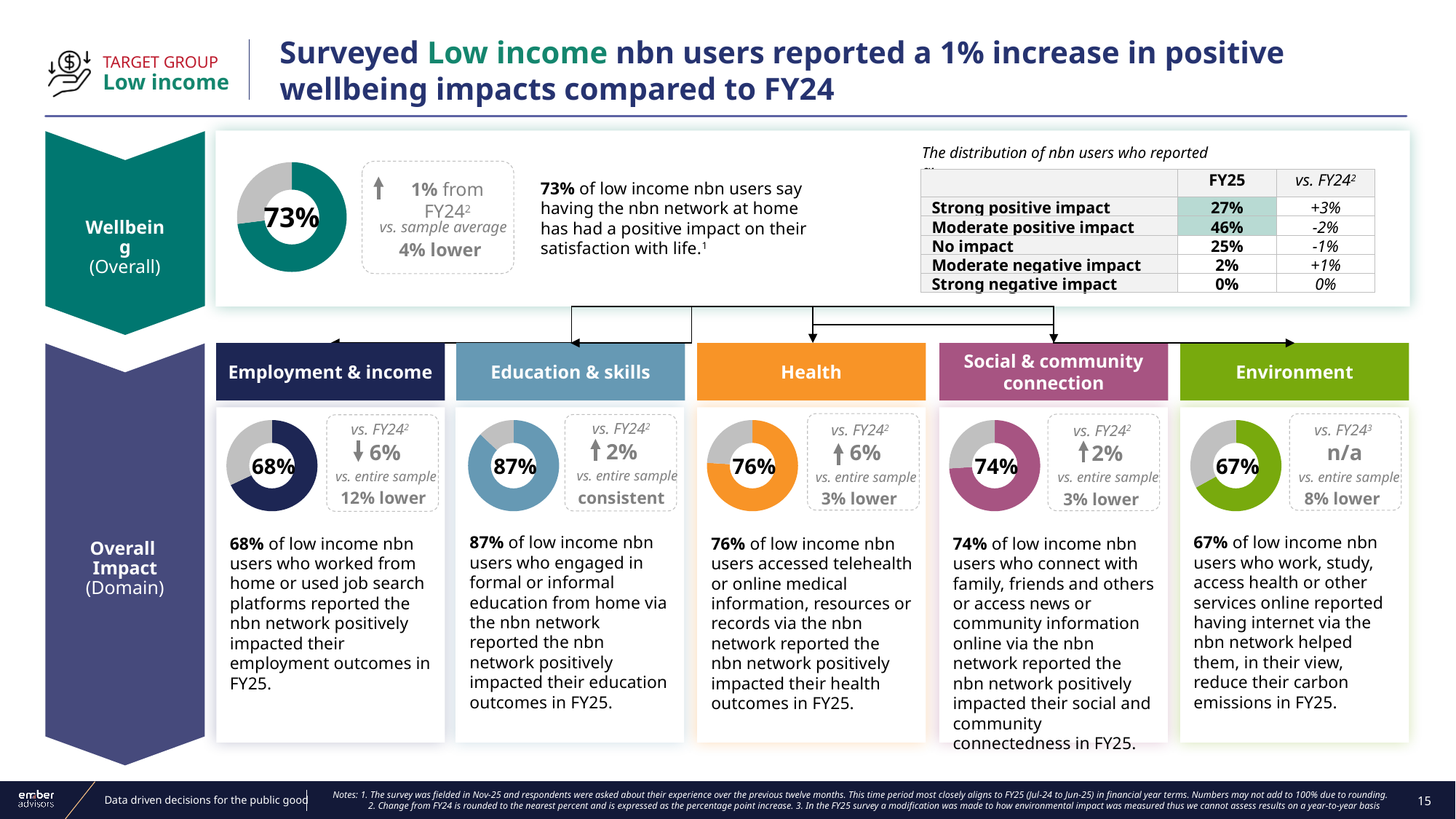
Among the five domain donut charts in the Overall Impact row, which domain has the lowest value? Environment Which is larger, the Health donut value or the Social & community connection donut value? Health What value is shown in the Social & community connection donut chart? 74% How many donut charts are shown in the Overall Impact (Domain) row? 5 Among the five domain donut charts in the Overall Impact row, which domain has the highest value? Education & skills What value is shown in the Environment donut chart? 67% What is the difference between the Education & skills donut value and the Employment & income donut value? 19% What kind of chart is used to show the 73% Wellbeing (Overall) figure? Donut chart What value is shown in the centre of the Wellbeing (Overall) donut chart? 73% What value is shown in the Health donut chart? 76% What value is shown in the Employment & income donut chart? 68% What value is shown in the Education & skills donut chart? 87%